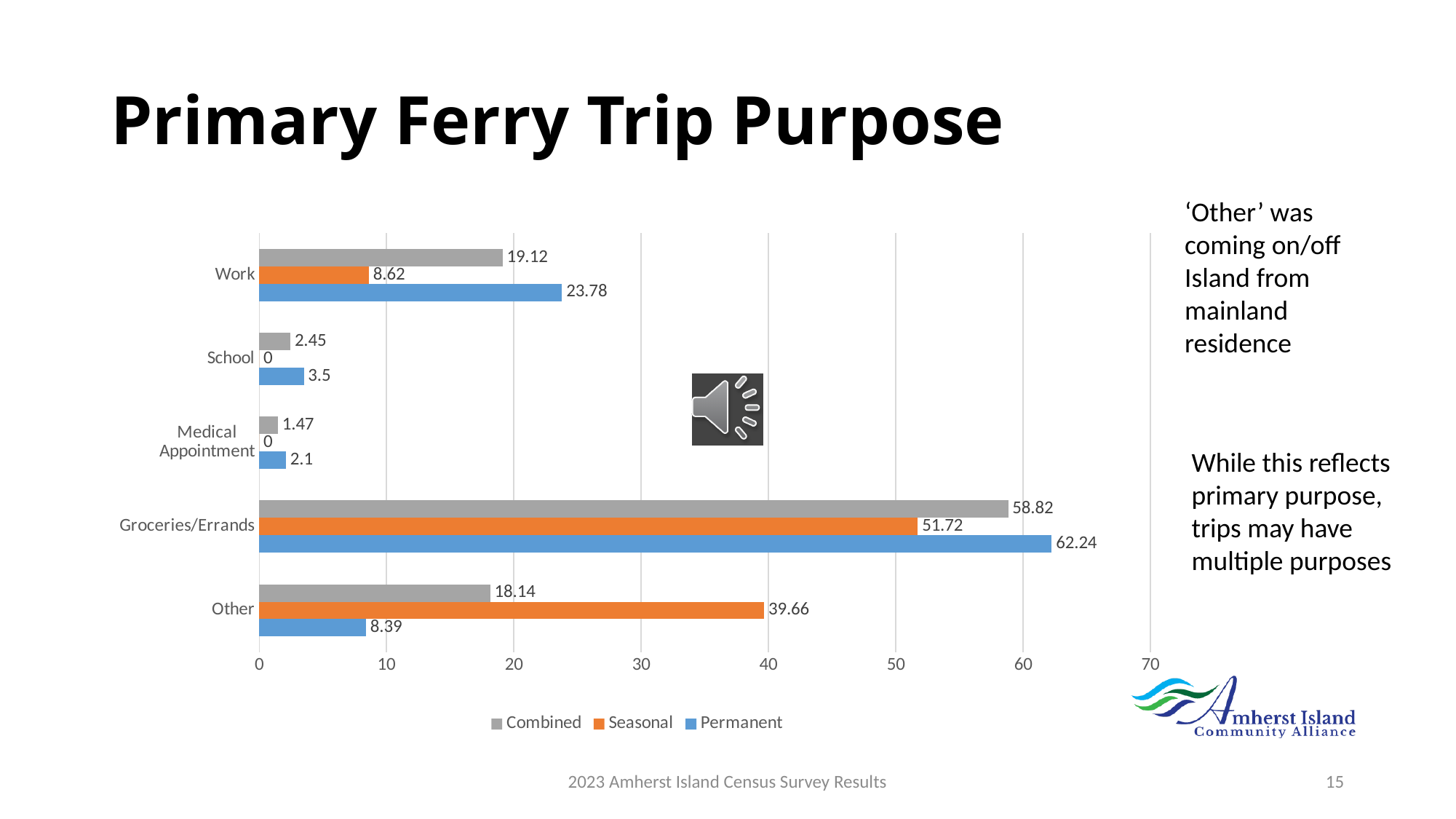
How many series does the legend list? 3 Which category has the lowest Combined value? Medical Appointment What is the Seasonal value for Other? 39.66 Which category has the highest Permanent value? Groceries/Errands What is the title of the slide containing the chart? Primary Ferry Trip Purpose For Other, which is larger: the Seasonal value or the Permanent value? Seasonal What is the Seasonal value for School? 0 What kind of chart is shown on the slide? Bar chart What is the Permanent value for Work? 23.78 What is the Combined value for Groceries/Errands? 58.82 What is the difference between the Permanent and Seasonal values for Groceries/Errands? 10.52 How many categories are shown on the y axis? 5